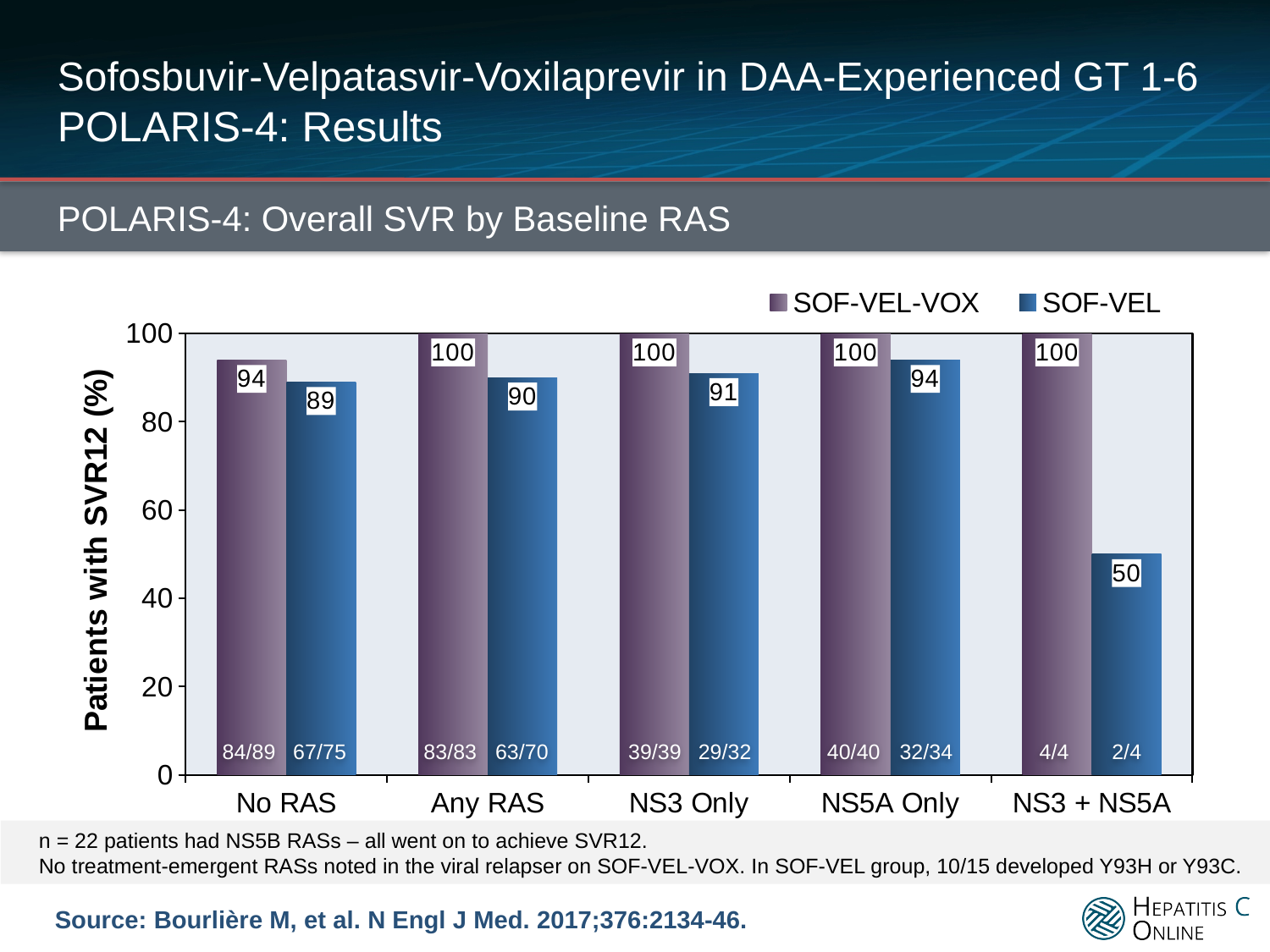
What is the difference between the SOF-VEL-VOX and SOF-VEL SVR12 rates in the NS3 + NS5A group? 50 How many series does the legend list? 2 What kind of chart is shown on the slide? Bar chart Which has a higher SVR12 rate in the NS3 Only group, SOF-VEL-VOX or SOF-VEL? SOF-VEL-VOX How many baseline RAS categories are shown on the x axis? 5 What is the label of the y axis? Patients with SVR12 (%) What is the difference between the SOF-VEL-VOX and SOF-VEL SVR12 rates in the NS5A Only group? 6 What is the SVR12 rate for SOF-VEL in the Any RAS group? 90 Which category has the lowest SVR12 rate for SOF-VEL? NS3 + NS5A What is the SVR12 rate for SOF-VEL in the NS3 + NS5A group? 50 What is the SVR12 rate for SOF-VEL-VOX in the No RAS group? 94 Which category has the lowest SVR12 rate for SOF-VEL-VOX? No RAS